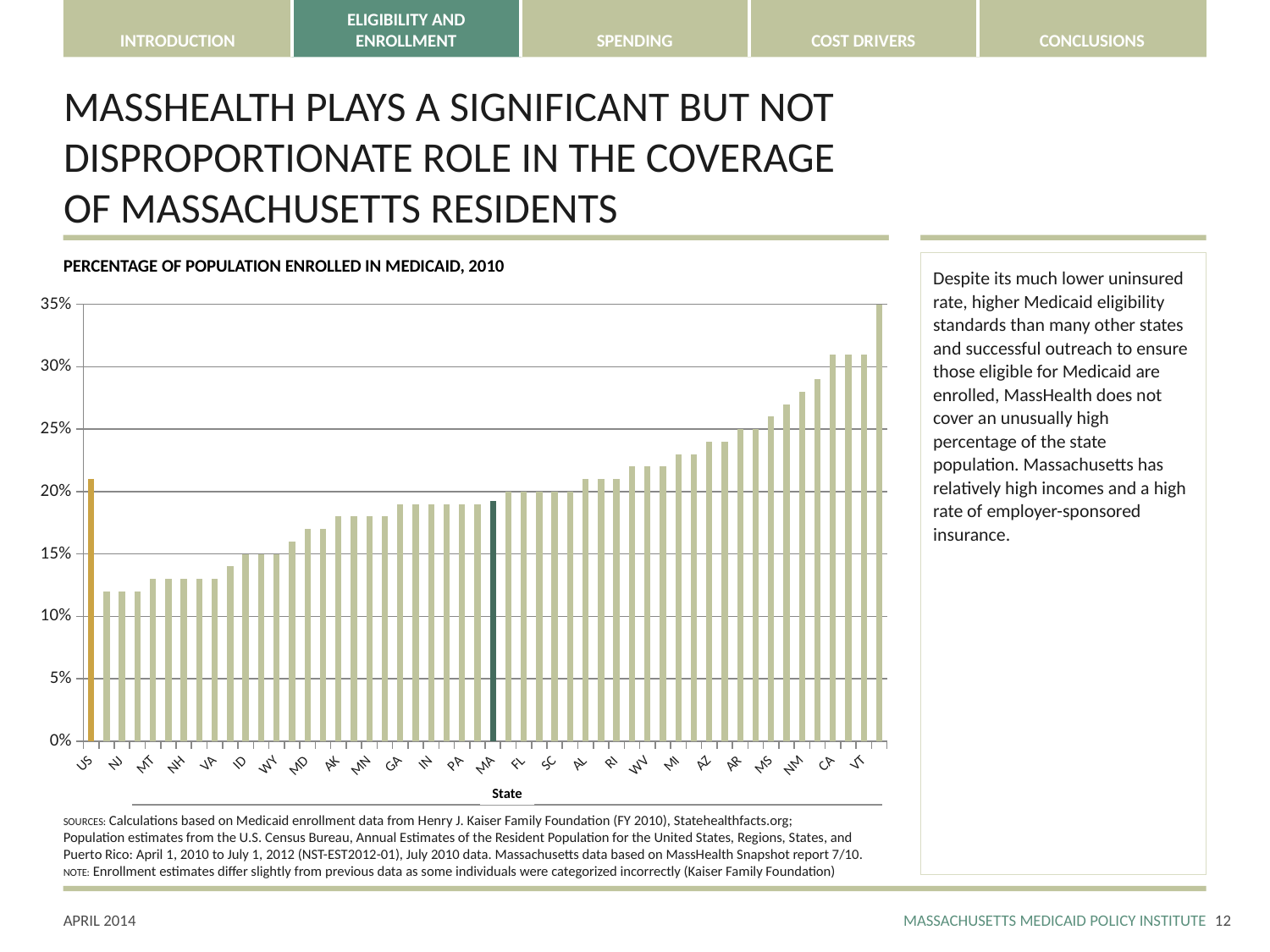
Do the values generally rise or fall moving from left to right along the x axis? Rise Is the value for MS greater or less than 25%? greater Is the value for MA greater or less than 20%? less Is the value for VT greater or less than 30%? greater What is the label on the x axis of the chart? State Which has a higher percentage enrolled in Medicaid, MA or US? US What kind of chart is shown on the slide? Bar chart What is the title of the chart? Percentage of Population Enrolled in Medicaid, 2010 Which has a higher percentage enrolled in Medicaid, CA or NJ? CA